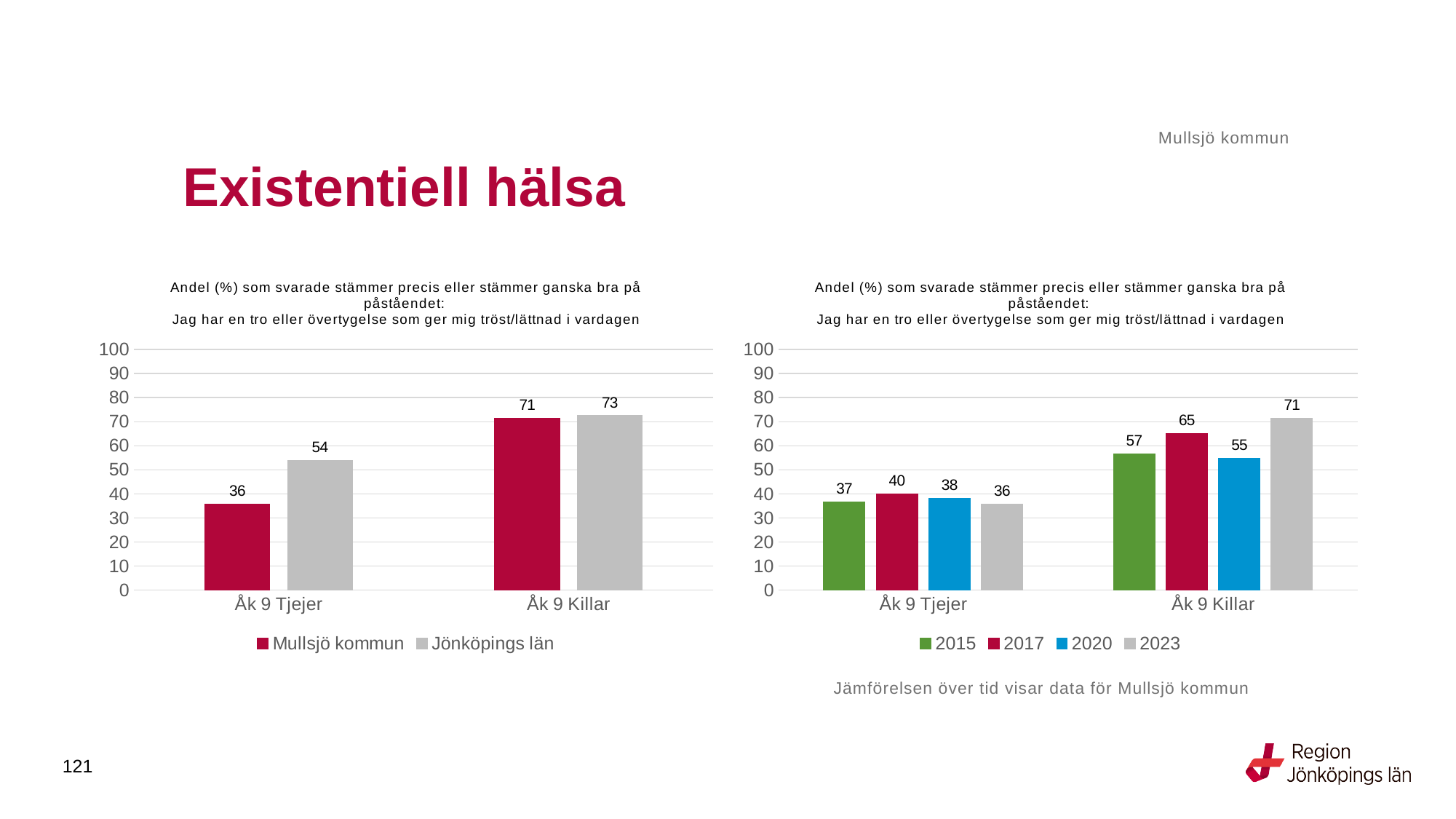
In the left chart, which is larger for Åk 9 Killar: Mullsjö kommun or Jönköpings län? Jönköpings län In the left chart, what is the value for Jönköpings län for Åk 9 Killar? 73 What kind of chart is the left chart? Bar chart In the right chart, how many series does the legend list? 4 In the right chart, what is the value for 2017 for Åk 9 Killar? 65 In the left chart, how many series does the legend list? 2 In the right chart, what is the difference between the 2023 and 2020 values for Åk 9 Killar? 16 In the right chart, which year has the lowest value for Åk 9 Tjejer? 2023 In the left chart, what is the difference between Jönköpings län and Mullsjö kommun for Åk 9 Tjejer? 18 In the right chart, which year has the highest value for Åk 9 Killar? 2023 In the left chart, what is the value for Mullsjö kommun for Åk 9 Tjejer? 36 In the right chart, what is the value for 2023 for Åk 9 Tjejer? 36